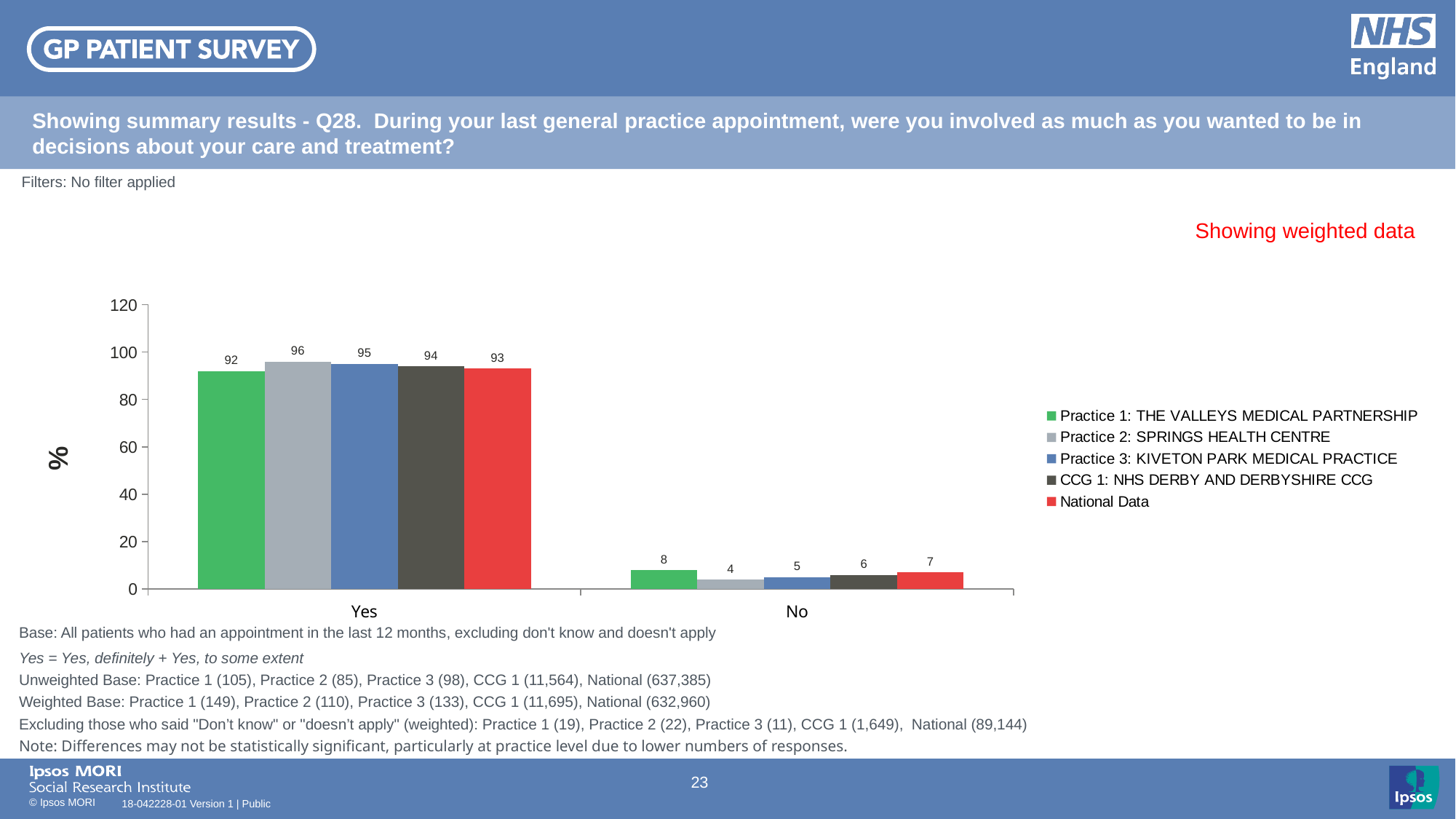
Which series has the lowest value in the No category? Practice 2: SPRINGS HEALTH CENTRE What is the difference between the Yes values for Practice 2: SPRINGS HEALTH CENTRE and Practice 1: THE VALLEYS MEDICAL PARTNERSHIP? 4 What colour represents National Data in the chart? red What is the value for Practice 2: SPRINGS HEALTH CENTRE in the No category? 4 Is the value for Practice 3: KIVETON PARK MEDICAL PRACTICE in the Yes category greater or less than 80? greater How many categories are shown on the x axis? 2 What is the value for National Data in the No category? 7 Which series has the highest value in the Yes category? Practice 2: SPRINGS HEALTH CENTRE What kind of chart is shown on the slide? bar chart How many series does the legend list? 5 Which is larger in the No category: Practice 1: THE VALLEYS MEDICAL PARTNERSHIP or CCG 1: NHS DERBY AND DERBYSHIRE CCG? Practice 1: THE VALLEYS MEDICAL PARTNERSHIP What is the value for Practice 1: THE VALLEYS MEDICAL PARTNERSHIP in the Yes category? 92